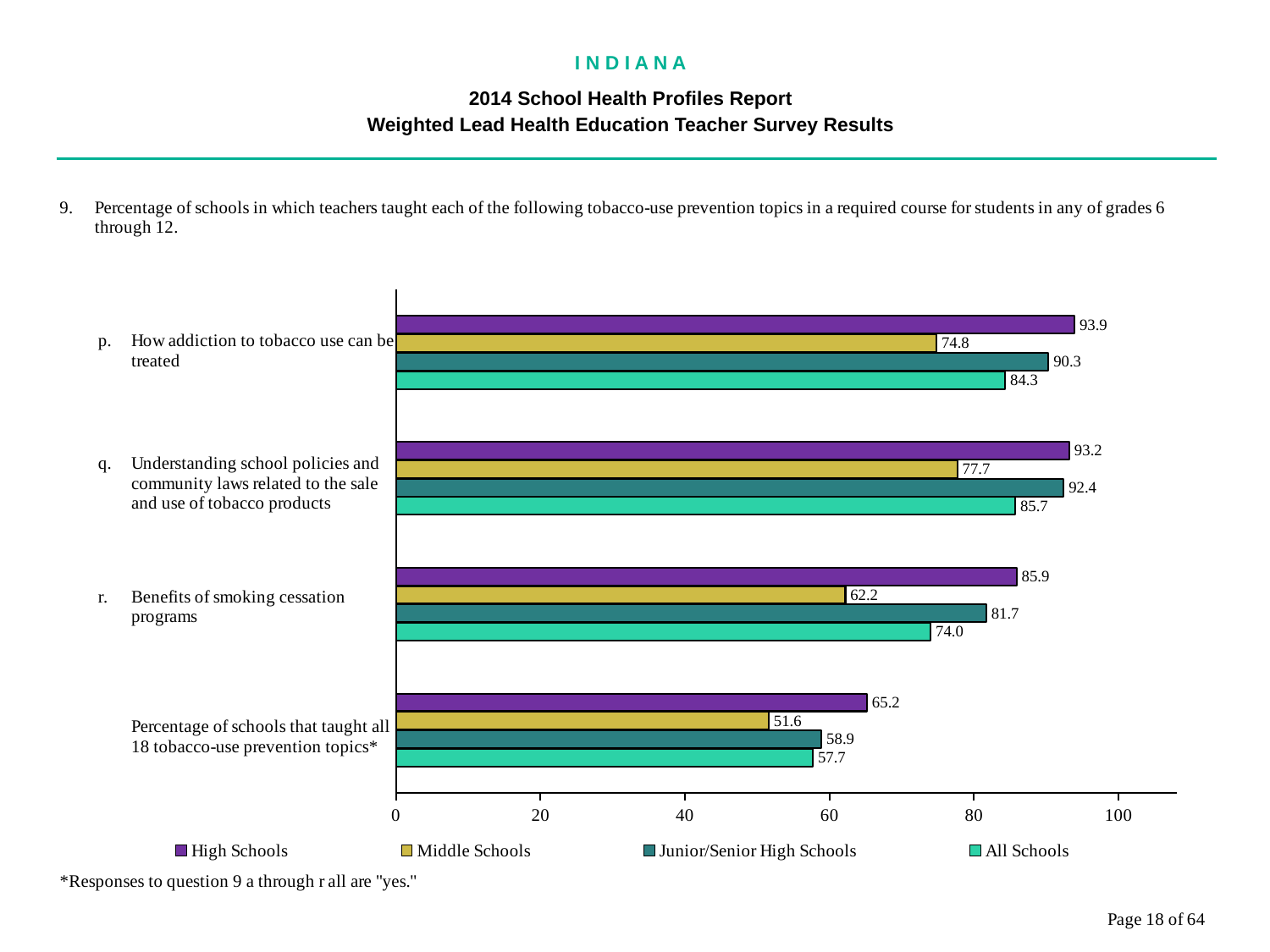
How many topic categories are shown on the chart? 4 What kind of chart is shown on the slide? Bar chart What is the value for High Schools for 'How addiction to tobacco use can be treated'? 93.9 Which school type has the highest value for 'Benefits of smoking cessation programs'? High Schools What is the value for Junior/Senior High Schools for 'Understanding school policies and community laws related to the sale and use of tobacco products'? 92.4 Which is larger for Middle Schools: 'How addiction to tobacco use can be treated' or 'Understanding school policies and community laws related to the sale and use of tobacco products'? Understanding school policies and community laws related to the sale and use of tobacco products Which series is shown in purple in the legend? High Schools How many series does the legend list? 4 What is the value for Middle Schools for 'Benefits of smoking cessation programs'? 62.2 What is the value for All Schools for 'Percentage of schools that taught all 18 tobacco-use prevention topics'? 57.7 Which school type has the lowest value for 'Percentage of schools that taught all 18 tobacco-use prevention topics'? Middle Schools What is the difference between the High Schools and Middle Schools values for 'Benefits of smoking cessation programs'? 23.7